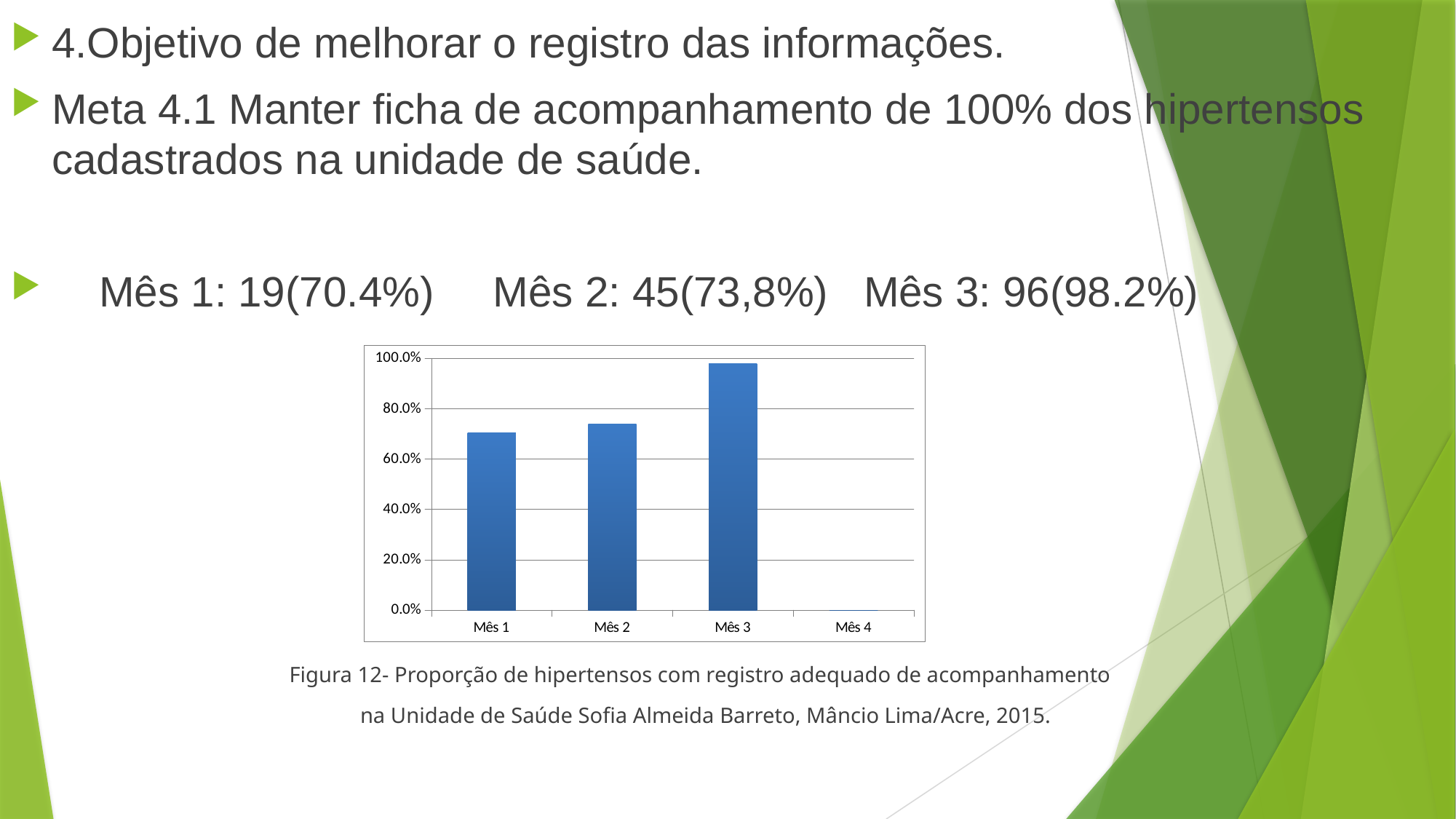
What is the proportion shown for Mês 1? 70.4% What kind of chart is shown on the slide? Bar chart What is the proportion shown for Mês 2? 73,8% How many months (categories) are shown on the x axis of the chart? 4 Is the value for Mês 3 greater or less than 80.0%? greater Which month has the highest bar in the chart? Mês 3 Which month has the lowest bar in the chart? Mês 4 What is the proportion shown for Mês 3? 98.2% Is the value for Mês 4 greater or less than 20.0%? less Which is larger, the bar for Mês 1 or the bar for Mês 2? Mês 2 Is the value for Mês 2 greater or less than 80.0%? less Do the bars rise or fall from Mês 1 to Mês 3? Rise